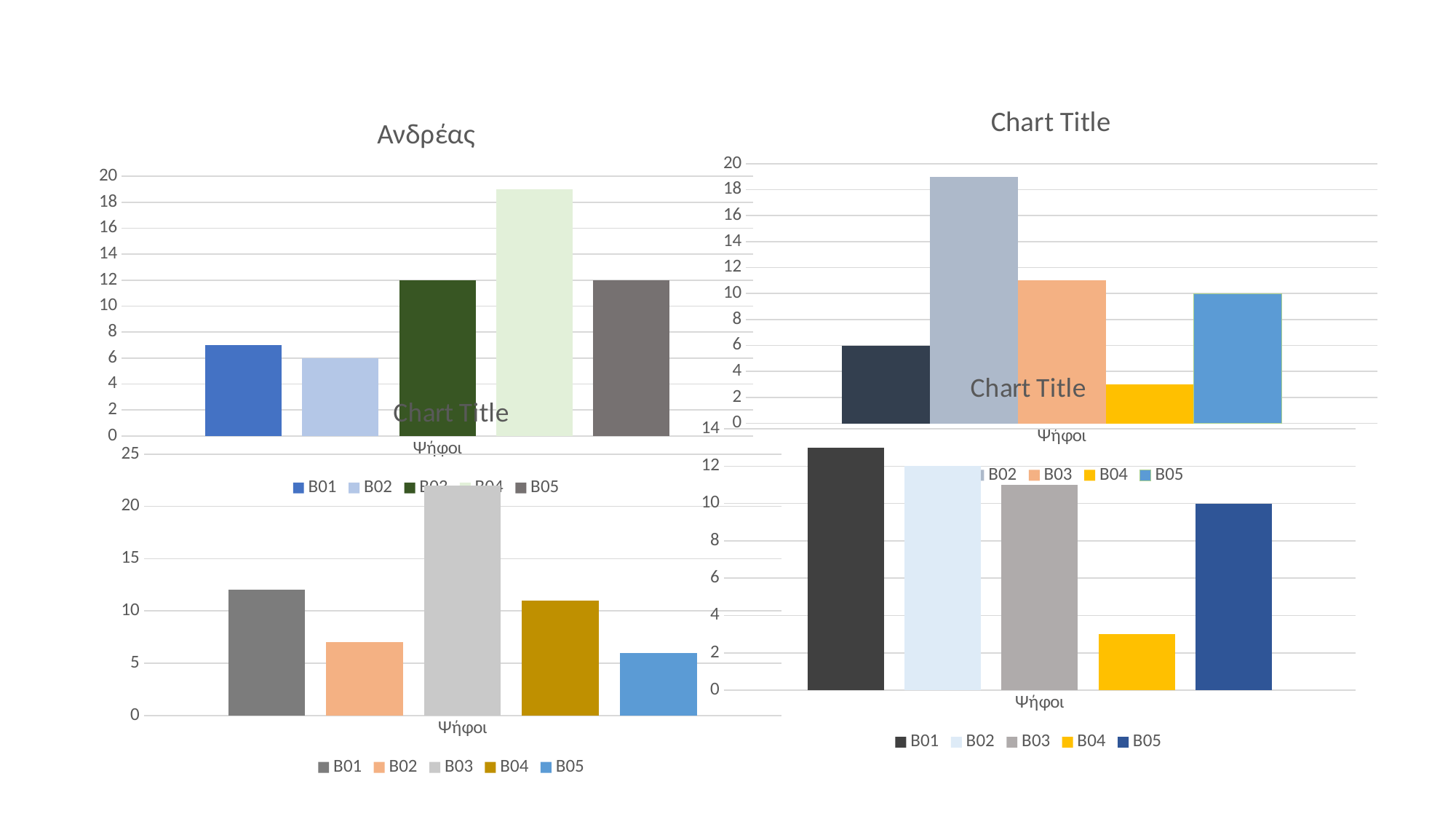
In the bottom-right chart, which is larger, the value for B01 or the value for B05? B01 In the top-left chart titled "Ανδρέας", which series has the lowest bar? B02 In the bottom-left chart, is the value for B03 greater or less than 20? greater In the top-left chart titled "Ανδρέας", is the value for B04 greater or less than 18? greater In the top-right chart, which series has the lowest bar? B04 In the top-left chart titled "Ανδρέας", how many series does the legend list? 5 In the bottom-left chart, which series has the highest bar? B03 In the top-left chart titled "Ανδρέας", which series has the highest bar? B04 In the bottom-right chart, which series has the lowest bar? B04 In the top-right chart, which series has the highest bar? B02 What kind of chart is the top-left chart titled "Ανδρέας"? bar chart In the top-right chart, what is the value for B01? 6